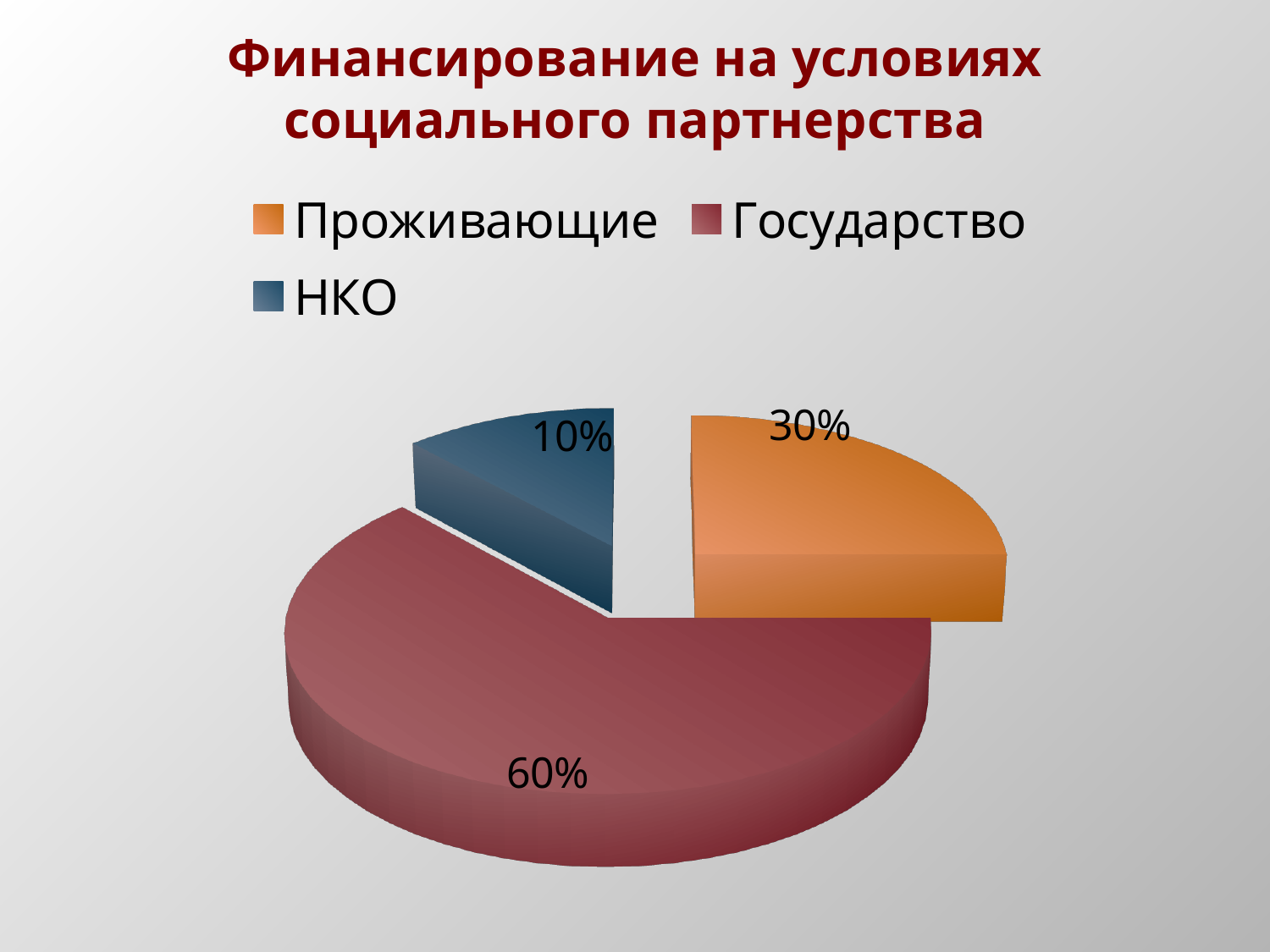
What share of the pie does НКО have? 10% How many categories are shown in the pie chart? 3 Which colour represents НКО in the legend? Blue Which category has the largest slice of the pie? Государство Which category has the smallest slice of the pie? НКО What is the title of the chart? Финансирование на условиях социального партнерства What kind of chart is shown on the slide? Pie chart What is the difference in percentage points between Проживающие and НКО? 20% What share of the pie does Проживающие have? 30% Which is larger, the share for Проживающие or the share for НКО? Проживающие What share of the pie does Государство have? 60% What is the difference in percentage points between Государство and Проживающие? 30%